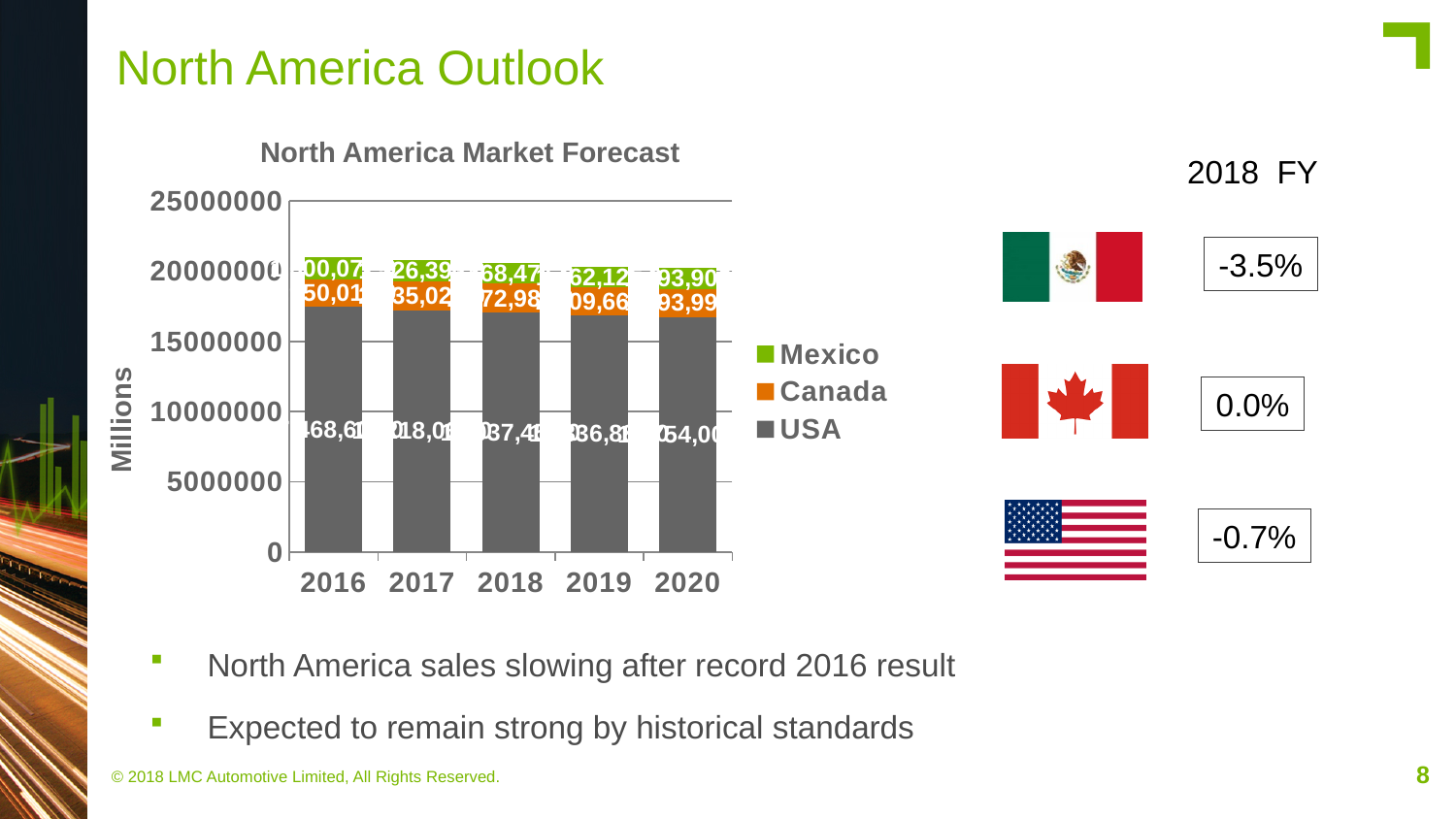
In the North America Market Forecast chart, is the total stacked bar for 2018 greater or less than 25000000? less What kind of chart is the North America Market Forecast? Stacked bar chart What are the series listed in the legend of the North America Market Forecast chart? Mexico, Canada, USA In the North America Market Forecast chart, is the USA value for 2020 greater or less than 20000000? less In the North America Market Forecast chart, does the USA segment rise or fall from 2016 to 2020? fall Which series makes up the largest part of each bar in the North America Market Forecast chart? USA How many series does the legend of the North America Market Forecast chart list? 3 How many years are shown on the x axis of the North America Market Forecast chart? 5 In the North America Market Forecast chart, is the USA value for 2016 greater or less than 15000000? greater In the North America Market Forecast chart, which is larger in 2016, the USA segment or the Mexico segment? USA What is the label on the vertical axis of the North America Market Forecast chart? Millions